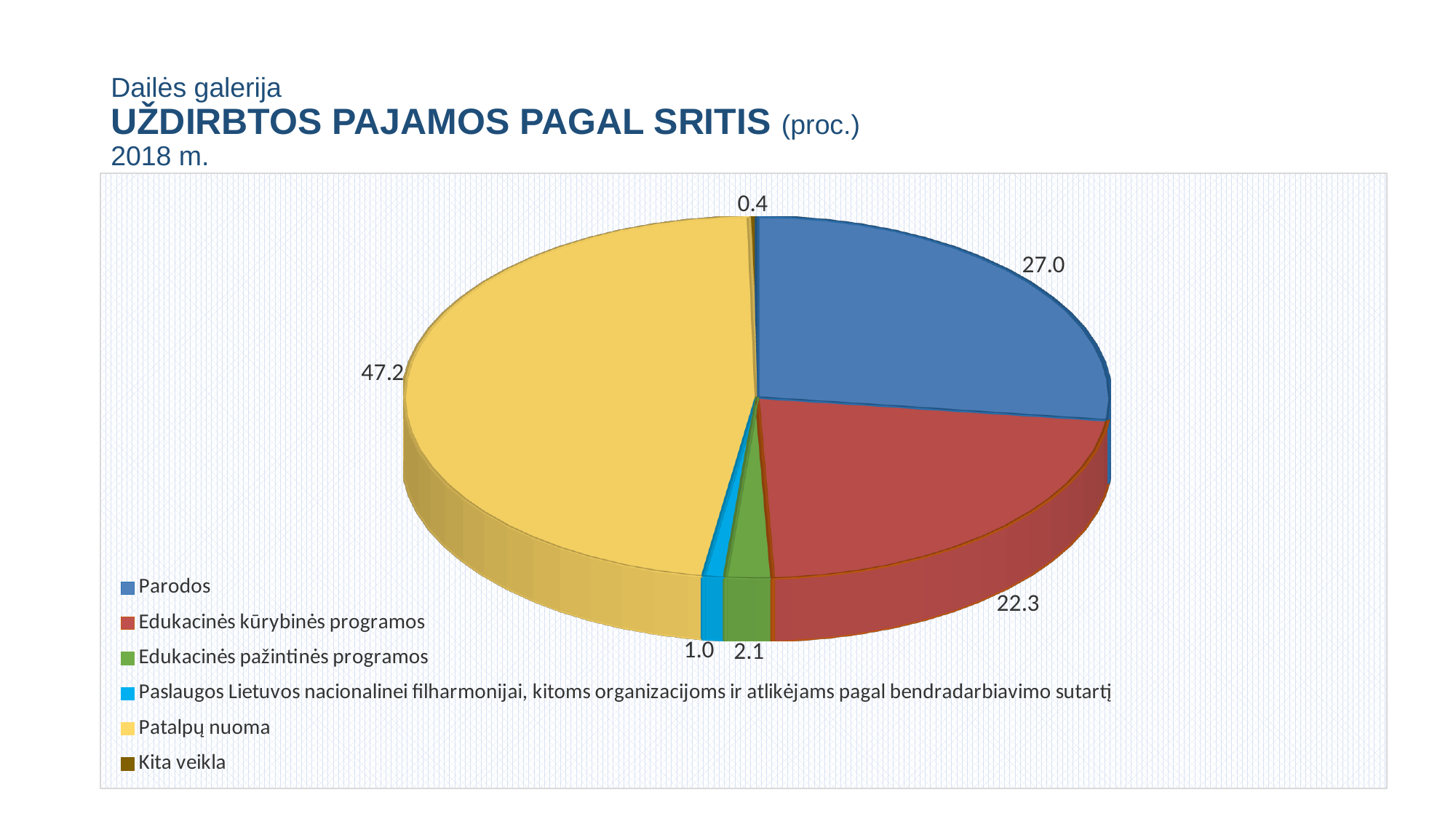
Which category has the largest share of the pie? Patalpų nuoma What is the value for Edukacinės kūrybinės programos? 22.3 What is the value for Patalpų nuoma? 47.2 What is the value for Kita veikla? 0.4 Which category has the smallest share of the pie? Kita veikla What is the value for Parodos? 27.0 How many categories does the legend list? 6 What kind of chart is shown on the slide? pie chart What is the value for Edukacinės pažintinės programos? 2.1 Which is larger, the value for Parodos or the value for Edukacinės kūrybinės programos? Parodos What colour is the slice for Patalpų nuoma? yellow What is the difference between the values for Parodos and Edukacinės kūrybinės programos? 4.7